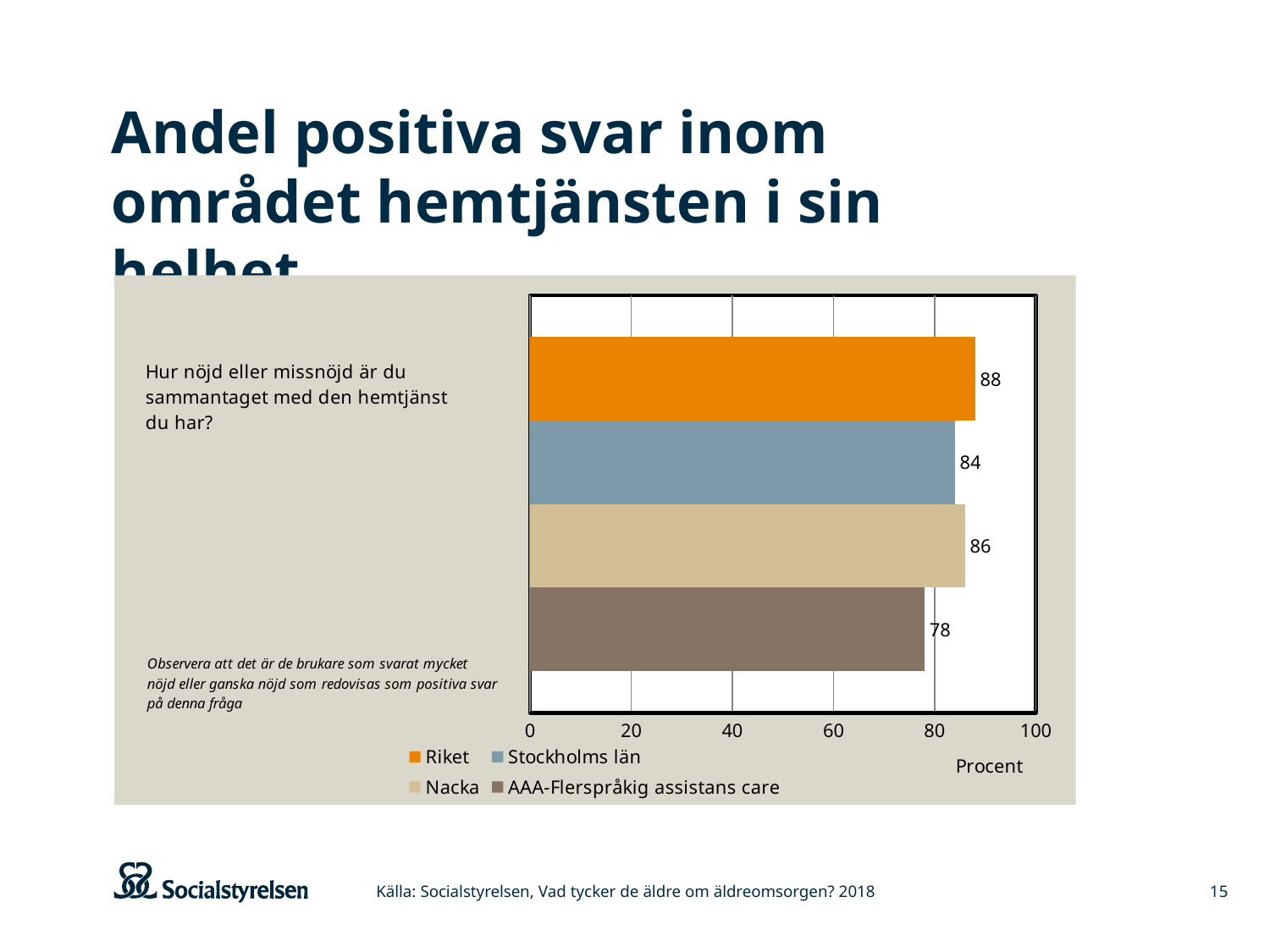
What is the value for Riket? 88 What is the value for Stockholms län? 84 What kind of chart is shown on the slide? Bar chart What is the value for AAA-Flerspråkig assistans care? 78 Which series has the lowest value? AAA-Flerspråkig assistans care What is the difference between the values for Nacka and Stockholms län? 2 What is the label of the horizontal axis? Procent Which series has the highest value? Riket What is the value for Nacka? 86 How many series does the legend list? 4 What is the difference between the values for Riket and AAA-Flerspråkig assistans care? 10 Which is larger, the value for Nacka or the value for Stockholms län? Nacka